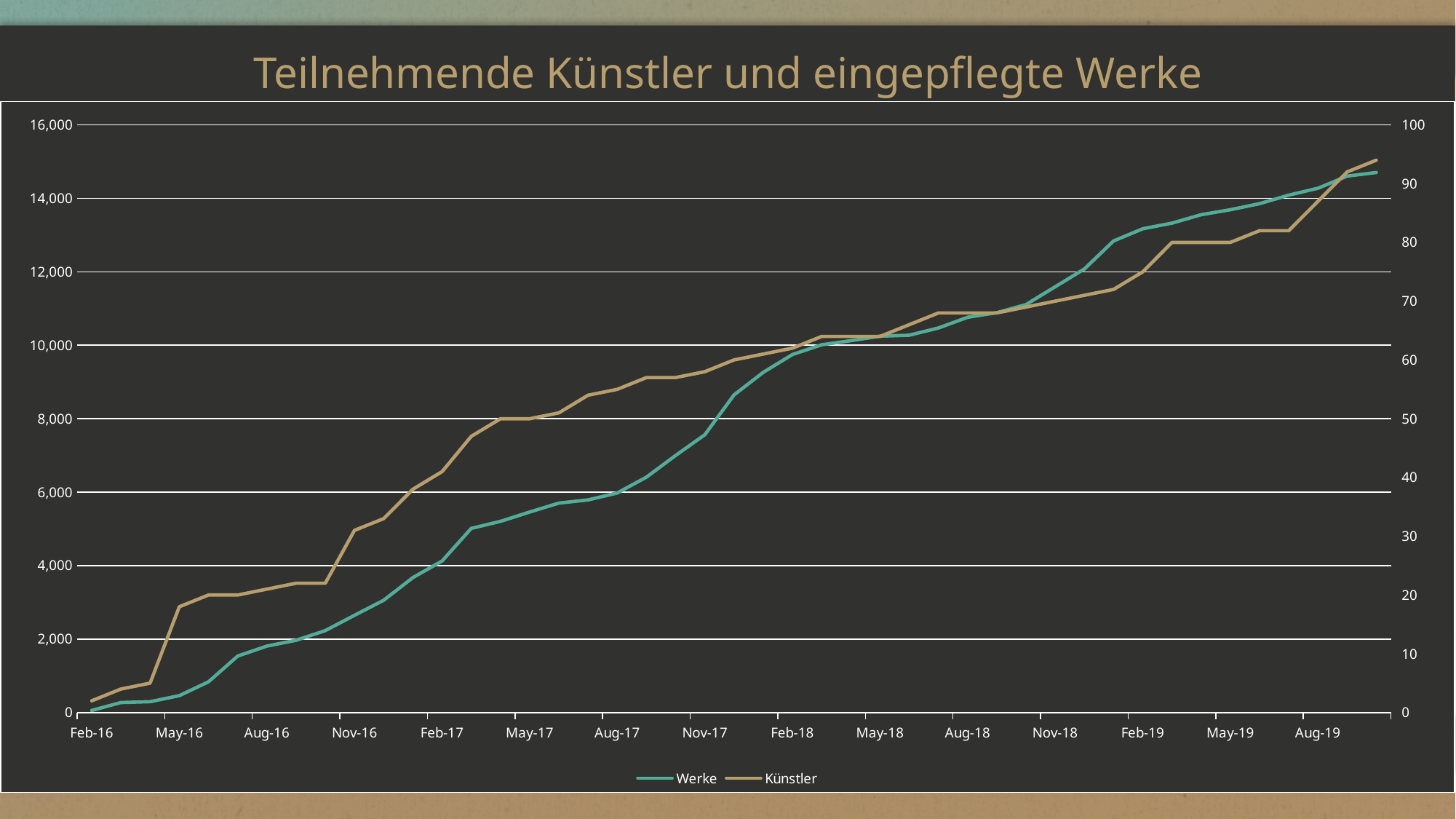
On the right-hand axis, is the value for Künstler at Feb-17 greater or less than 30? greater What kind of chart is shown on the slide? line chart What are the two series named in the legend? Werke and Künstler How many series does the legend list? 2 Is the value for Werke at Feb-18 greater or less than 8,000? greater What is the title of the chart? Teilnehmende Künstler und eingepflegte Werke Is the value for Werke at Aug-17 greater or less than 8,000? less Does the Werke line rise or fall from Feb-16 to Aug-19? rise How many date labels are shown on the x axis? 15 Does the Künstler line rise or fall over the period shown? rise